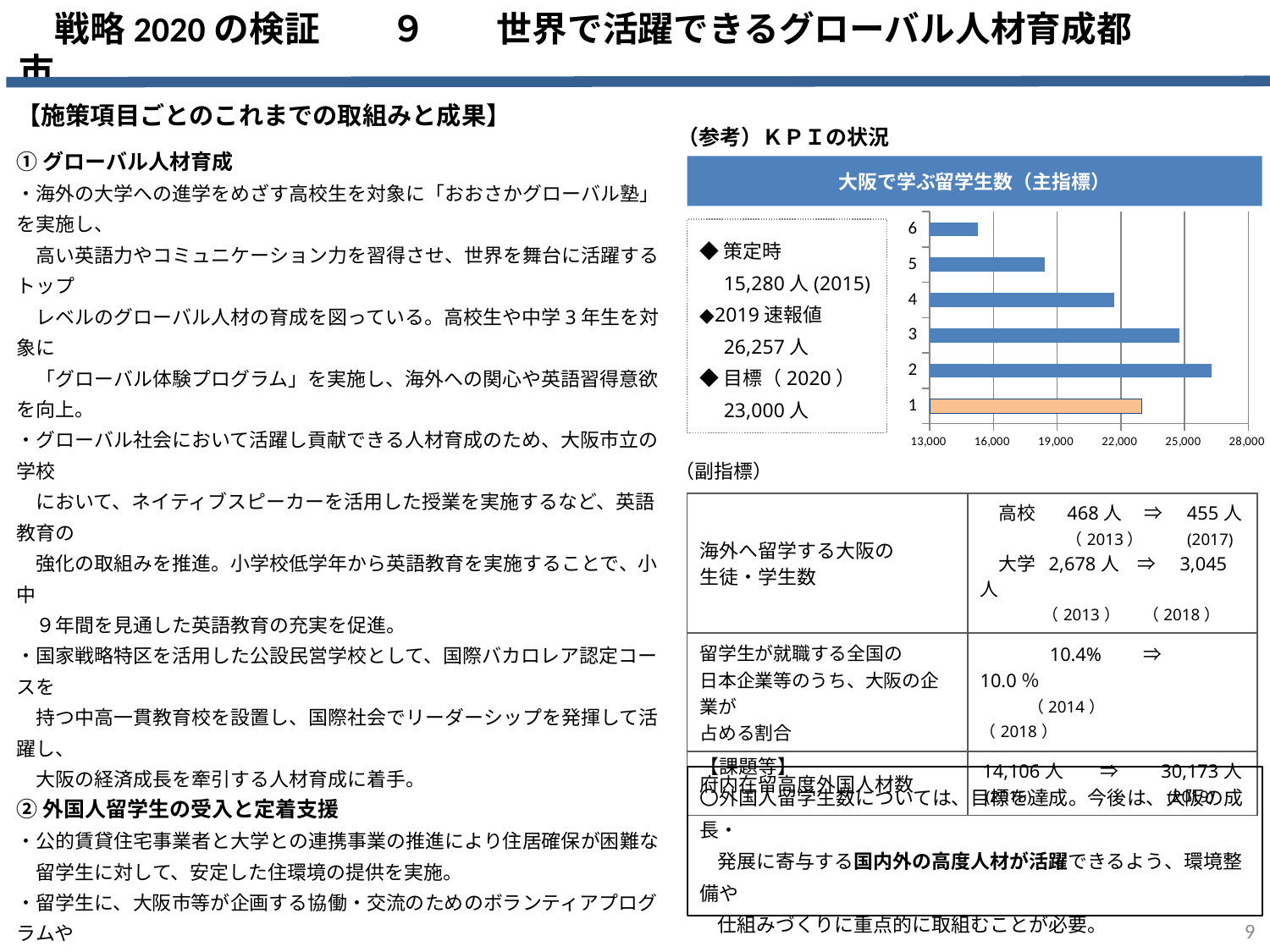
In the 大阪で学ぶ留学生数 chart, which category's bar is coloured orange instead of blue? 1 In the 大阪で学ぶ留学生数 chart, which bar is longer, category 4 or category 6? 4 In the 大阪で学ぶ留学生数 chart, which category has the longest bar? 2 In the 大阪で学ぶ留学生数 chart, do the bars get longer or shorter going from category 2 down to category 6? shorter In the 大阪で学ぶ留学生数 chart, is the value for category 2 greater or less than 25,000? greater In the 大阪で学ぶ留学生数 chart, which category has the shortest bar? 6 In the 大阪で学ぶ留学生数 chart, is the value for category 6 greater or less than 16,000? less In the 大阪で学ぶ留学生数 chart, is the value for category 5 greater or less than 19,000? less How many categories are plotted on the y axis of the 大阪で学ぶ留学生数 chart? 6 What kind of chart is shown under the heading 大阪で学ぶ留学生数（主指標）? bar chart What is the largest tick value shown on the x axis of the 大阪で学ぶ留学生数 chart? 28,000